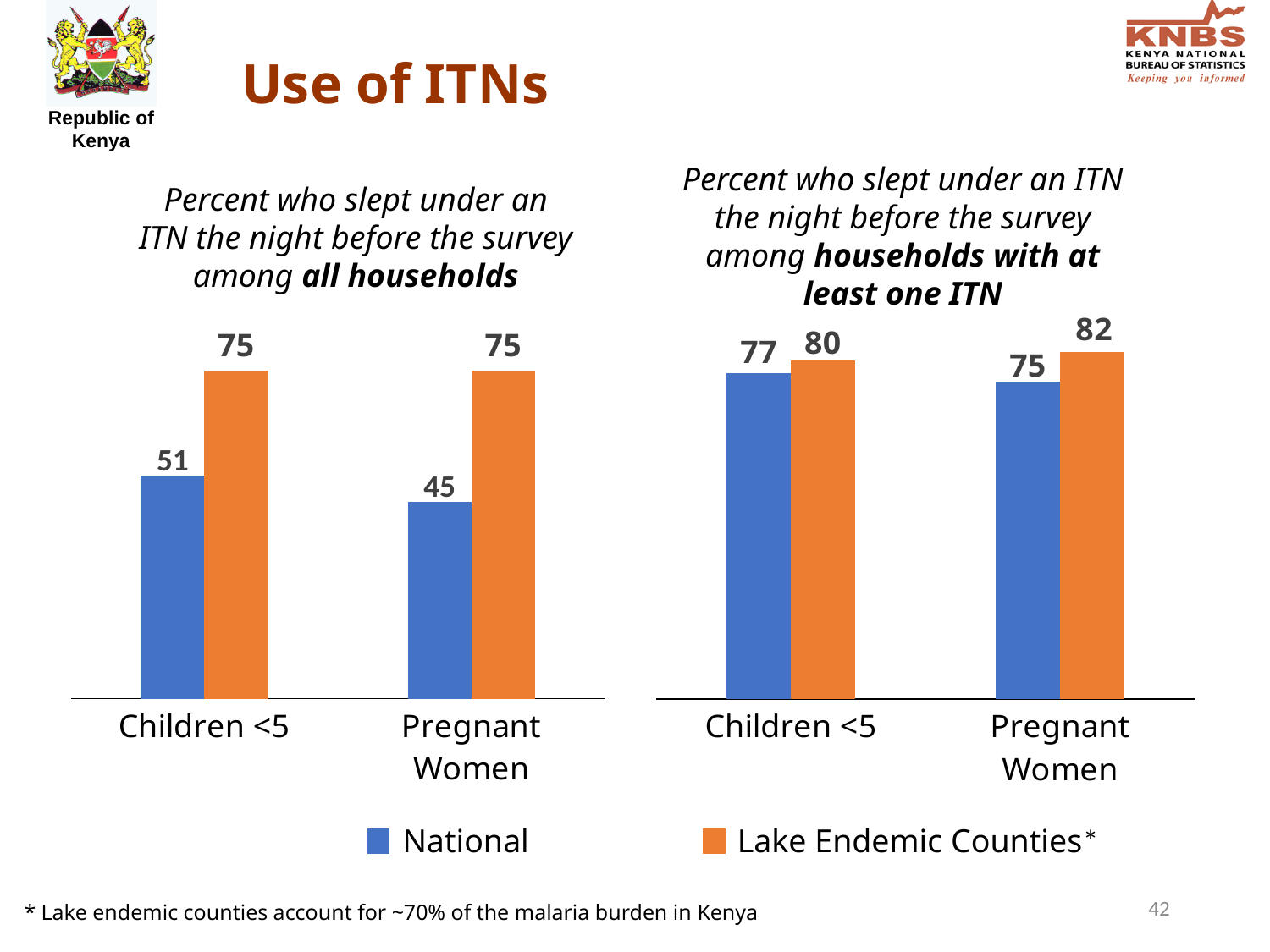
In the right chart (households with at least one ITN), what is the Lake Endemic Counties value for Children <5? 80 In the left chart (all households), which category has the lower National value? Pregnant Women What kind of chart is the left chart (all households)? bar chart In the right chart (households with at least one ITN), what is the difference between the Lake Endemic Counties and National values for Children <5? 3 In the right chart (households with at least one ITN), what is the National value for Pregnant Women? 75 In the left chart (all households), is the National value for Children <5 larger or smaller than the Lake Endemic Counties value for Children <5? smaller How many series does the legend list? 2 In the left chart (all households), what is the Lake Endemic Counties value for Pregnant Women? 75 In the left chart (all households), what is the difference between the Lake Endemic Counties and National values for Pregnant Women? 30 In the left chart (all households), what is the National value for Children <5? 51 Which series is shown in orange in the legend? Lake Endemic Counties* In the right chart (households with at least one ITN), which category has the higher Lake Endemic Counties value? Pregnant Women